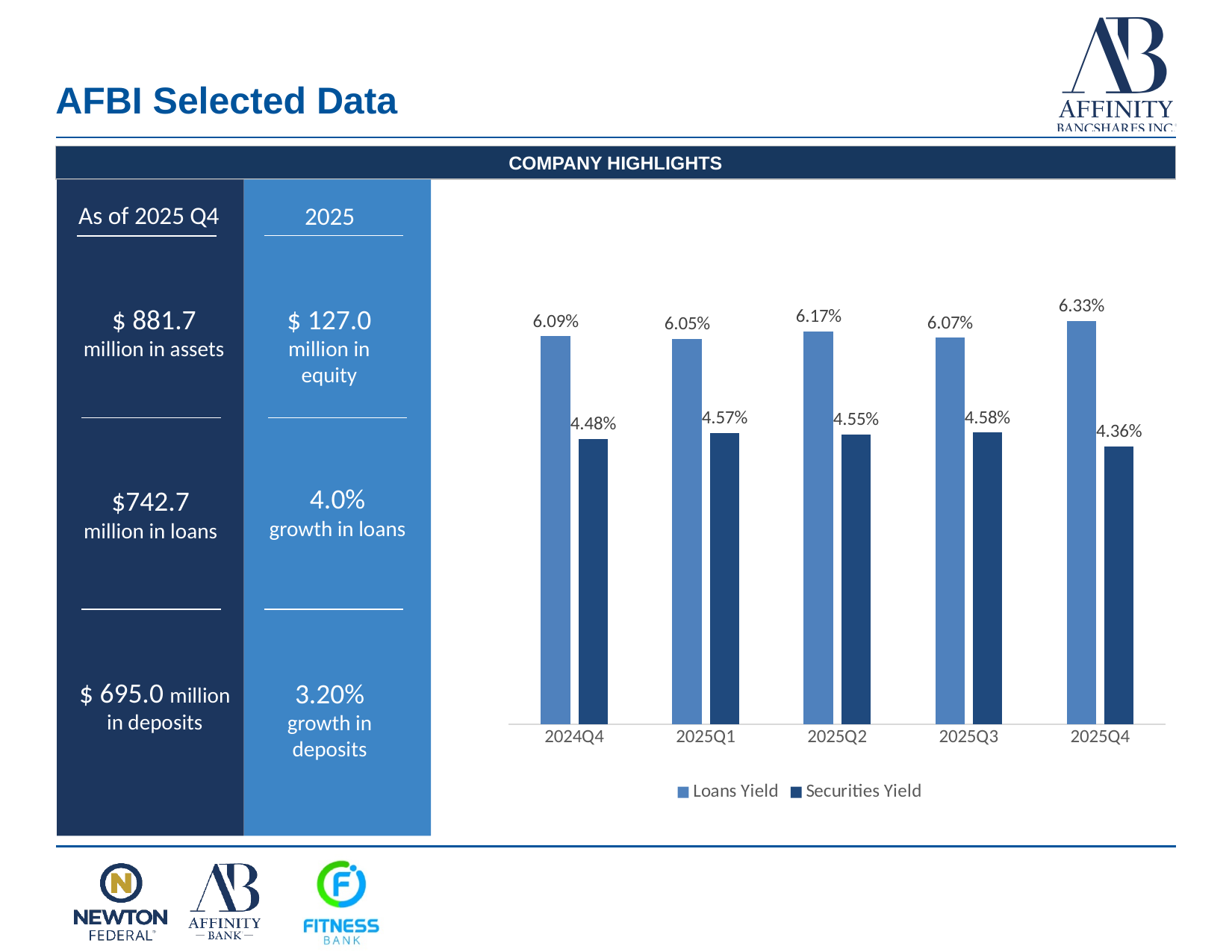
What is the Securities Yield for 2024Q4? 4.48% Which series is shown in the darker blue bars? Securities Yield What is the difference between the Loans Yield and the Securities Yield in 2025Q4? 1.97% Which is larger, the Securities Yield in 2025Q1 or in 2025Q4? 2025Q1 What kind of chart is shown on the slide? Bar chart Which quarter has the highest Loans Yield? 2025Q4 Which quarter has the lowest Securities Yield? 2025Q4 What is the Loans Yield for 2025Q4? 6.33% What is the difference between the Loans Yield in 2025Q2 and in 2025Q1? 0.12% How many quarters are shown on the x axis of the chart? 5 What is the Securities Yield for 2025Q3? 4.58% How many series does the chart legend list? 2